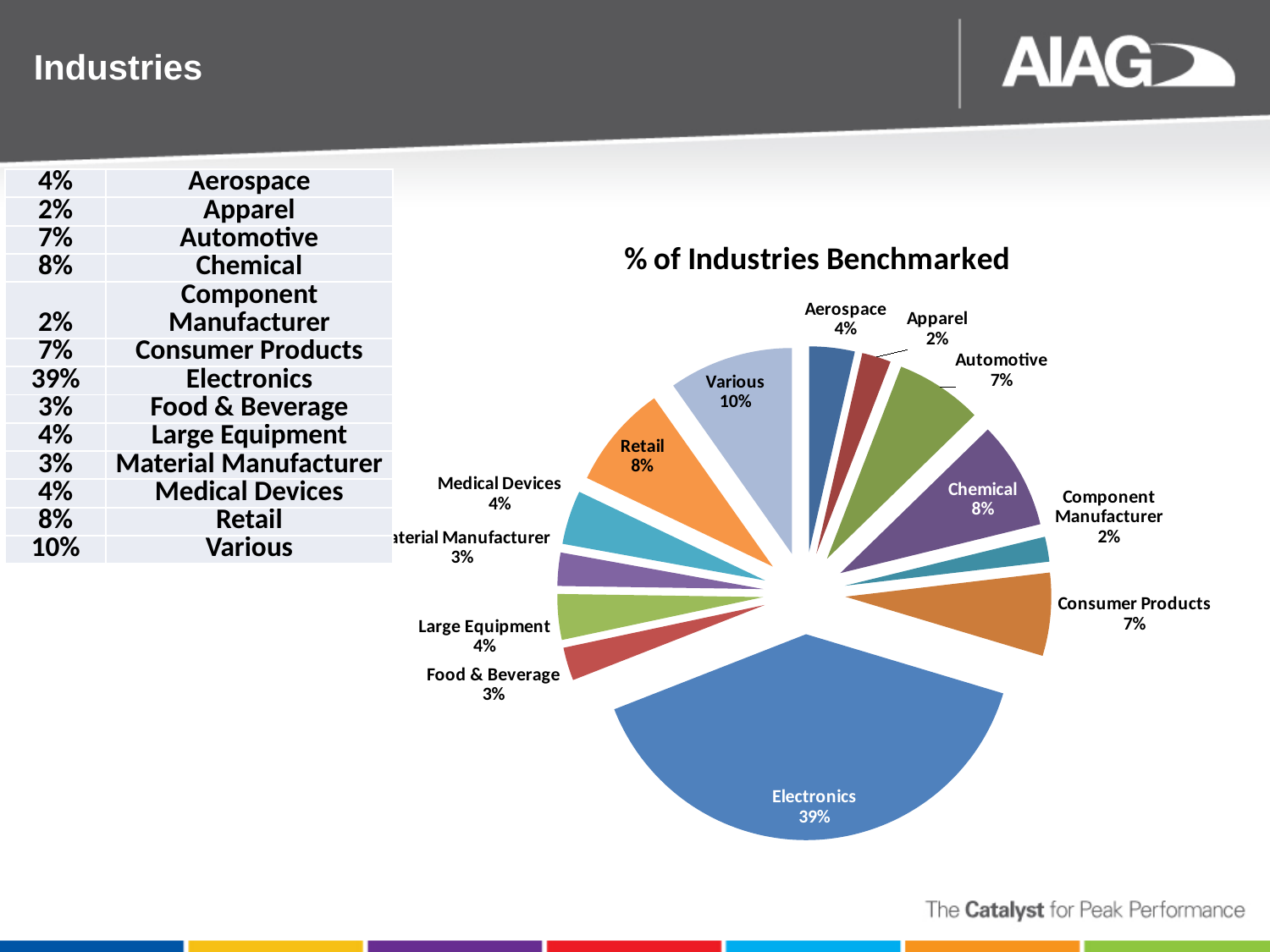
Which industry has the largest slice of the pie? Electronics What share of the pie does Electronics hold? 39% What is the difference between the Electronics share and the Various share? 29% What is the value for Chemical? 8% What is the combined share of Retail and Medical Devices? 12% What is the title of the chart? % of Industries Benchmarked What kind of chart is shown on the slide? pie chart What is the value for Various? 10% How many industry categories are shown in the pie chart? 13 Is the share for Retail larger than the share for Consumer Products? Yes Which industry has the smallest share, Apparel or Automotive? Apparel What is the value for Component Manufacturer? 2%